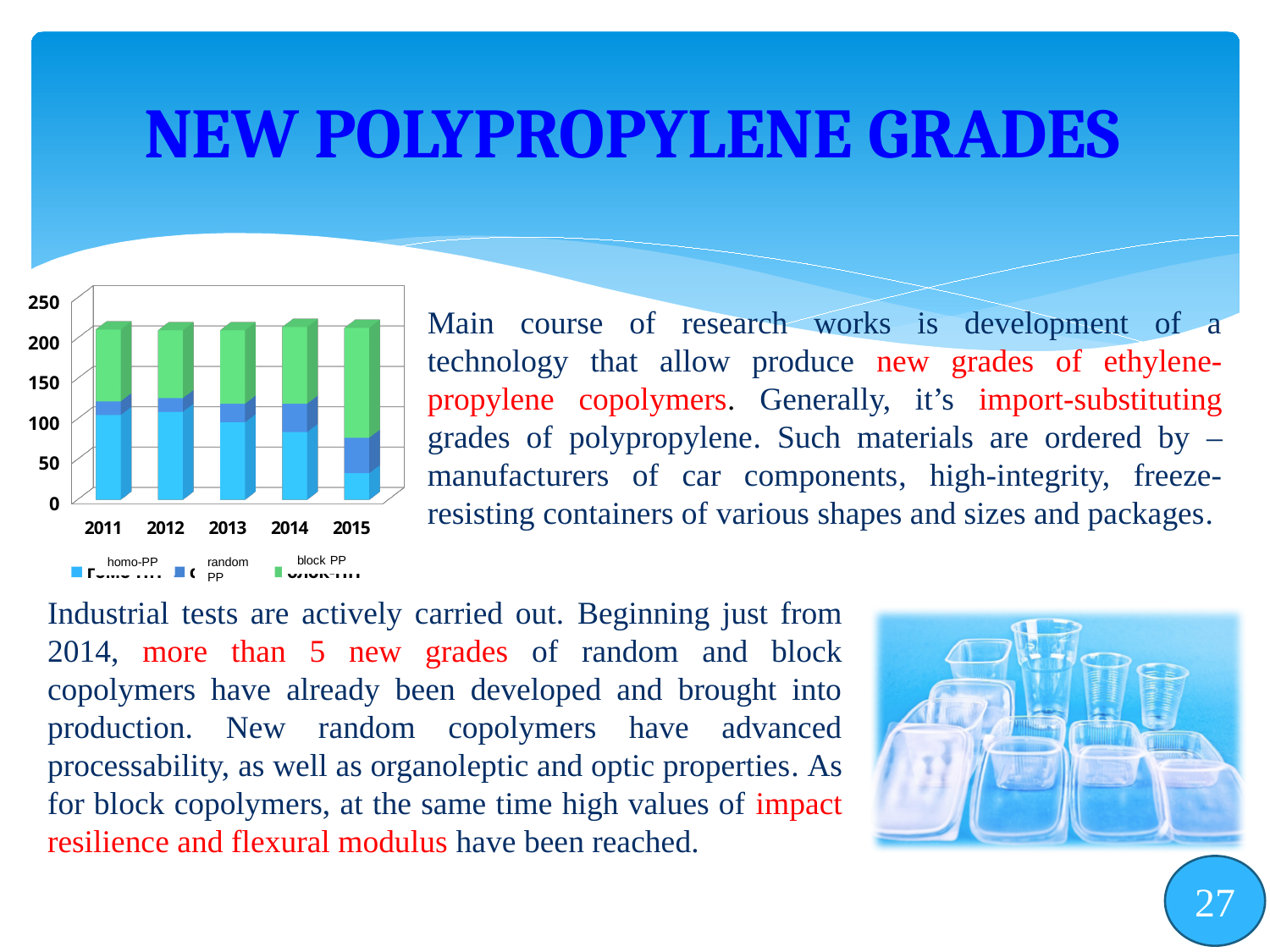
How many series does the chart legend list? 3 Which series are listed in the chart legend? homo-PP, random PP, block PP Is the value for homo-PP in 2011 greater or less than 50? greater Which is larger, the homo-PP value in 2011 or in 2015? 2011 What kind of chart is shown on the slide? stacked bar chart Which year is the first category on the x axis of the chart? 2011 In 2015, which series has the largest segment in the stacked bar? block PP In which year is the homo-PP segment the smallest? 2015 Is the total stacked bar for 2013 greater or less than 200? greater How many years are shown on the x axis of the chart? 5 Does the homo-PP segment rise or fall from 2011 to 2015? fall Is the value for homo-PP in 2015 greater or less than 50? less